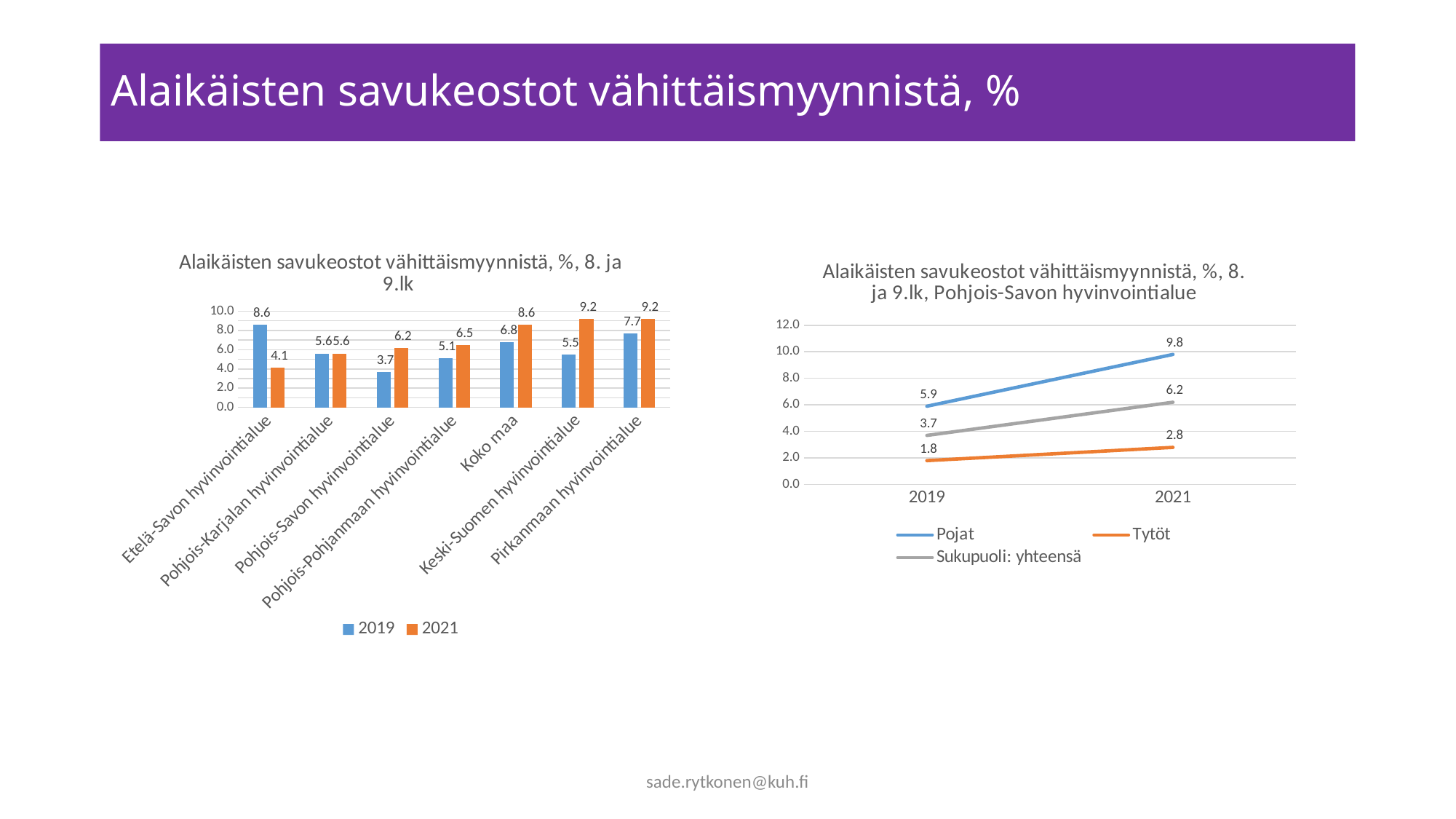
In the left chart, what is the difference between the 2021 and 2019 values for Keski-Suomen hyvinvointialue? 3.7 In the right chart, what is the value for Pojat in 2021? 9.8 What type of chart is the left chart? Bar chart In the left chart, which is larger for Etelä-Savon hyvinvointialue, the 2019 value or the 2021 value? 2019 In the left chart, what is the 2019 value for Etelä-Savon hyvinvointialue? 8.6 In the right chart, what is the difference between the Pojat and Tytöt values in 2021? 7.0 In the left chart, which category has the lowest 2019 value? Pohjois-Savon hyvinvointialue In the left chart, what is the 2021 value for Pohjois-Savon hyvinvointialue? 6.2 In the right chart, does the Sukupuoli: yhteensä line rise or fall from 2019 to 2021? Rise How many categories are shown on the x axis of the left chart? 7 In the right chart, what is the value for Tytöt in 2019? 1.8 How many series does the legend of the right chart list? 3